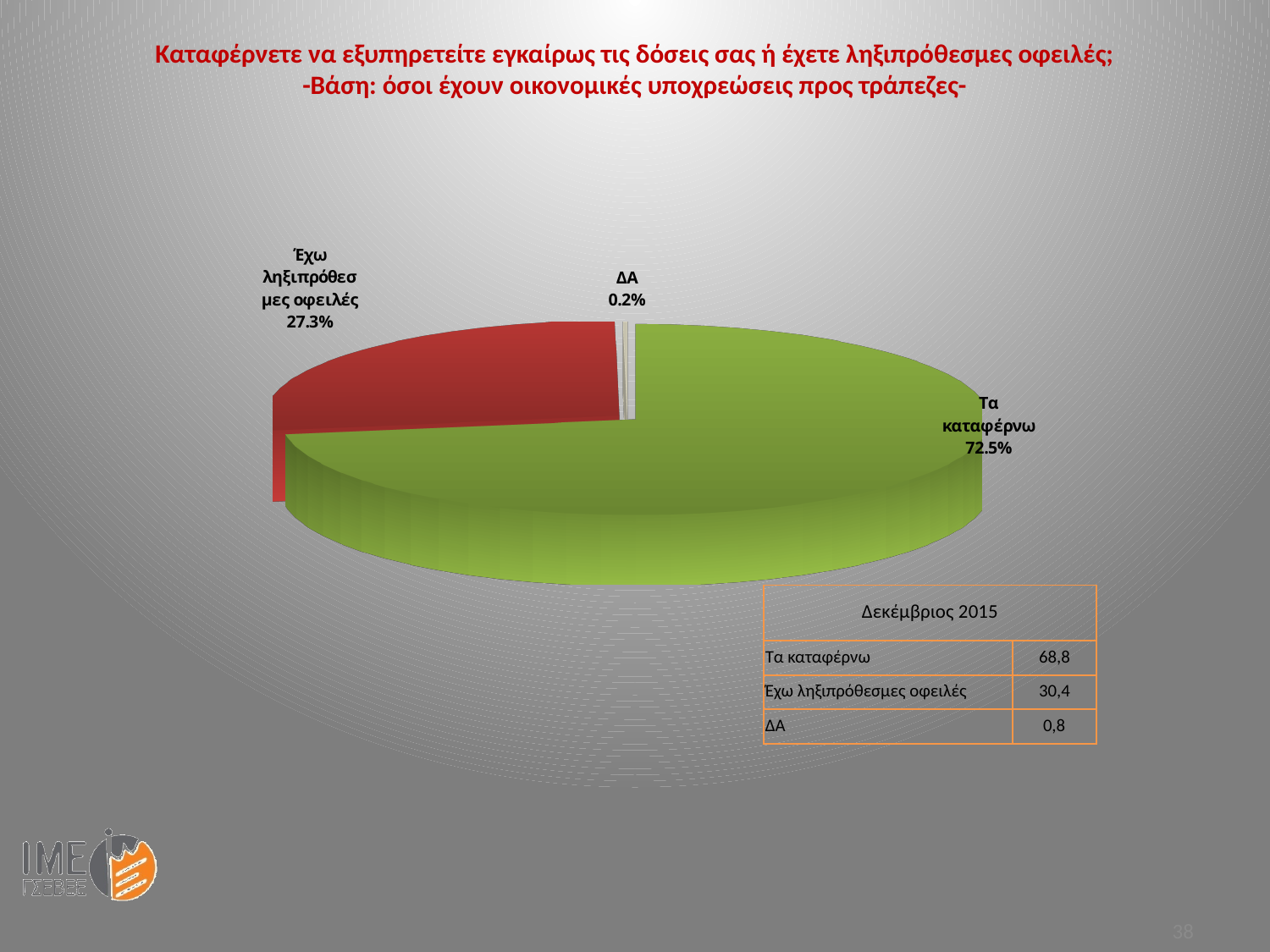
What percentage of the pie chart is labelled "ΔΑ"? 0.2% Which slice of the pie chart is the smallest? ΔΑ What colour is the "Τα καταφέρνω" slice of the pie chart? green Which slice of the pie chart is the largest? Τα καταφέρνω What share of the pie does the green slice represent? 72.5% Which is larger in the pie chart: "Έχω ληξιπρόθεσμες οφειλές" or "ΔΑ"? Έχω ληξιπρόθεσμες οφειλές How many slices does the pie chart have? 3 What percentage of the pie chart is labelled "Τα καταφέρνω"? 72.5% What kind of chart is shown on the slide? pie chart What percentage of the pie chart is labelled "Έχω ληξιπρόθεσμες οφειλές"? 27.3% What colour is the "Έχω ληξιπρόθεσμες οφειλές" slice of the pie chart? red What is the difference in percentage points between the "Τα καταφέρνω" slice and the "Έχω ληξιπρόθεσμες οφειλές" slice? 45.2 percentage points